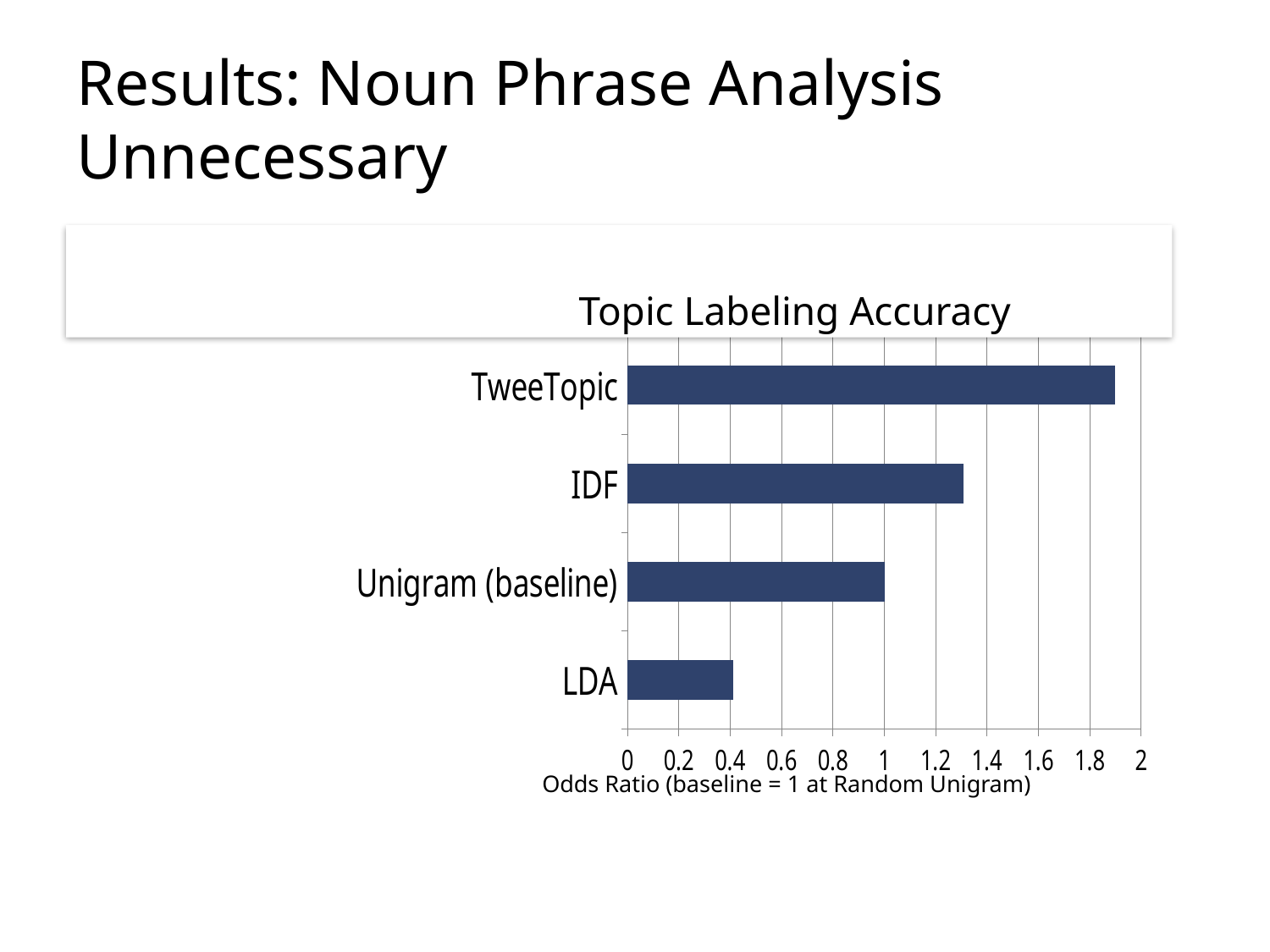
Is the value for IDF greater or less than 1.2? greater What is the odds ratio for Unigram (baseline)? 1 Is the value for IDF greater or less than 1.4? less What is the title of the chart? Topic Labeling Accuracy What is the x-axis label of the chart? Odds Ratio (baseline = 1 at Random Unigram) Is the value for TweeTopic greater or less than 1.8? greater What kind of chart is shown on the slide? bar chart Which has a larger odds ratio, IDF or Unigram (baseline)? IDF Which category has the lowest odds ratio? LDA How many categories are plotted in the chart? 4 Which category has the highest odds ratio? TweeTopic